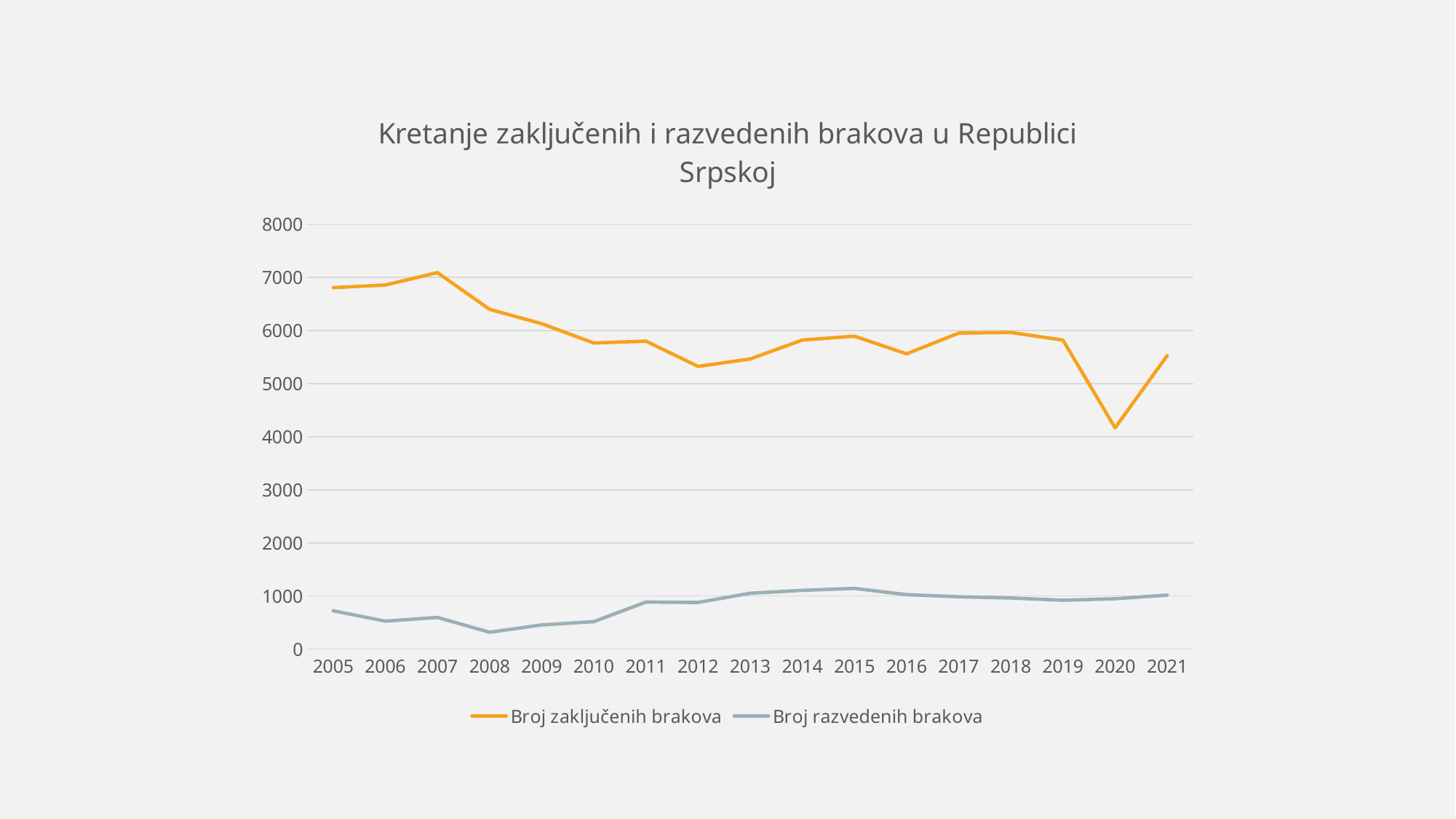
Is the value for Broj razvedenih brakova in 2008 greater or less than 500? less In which year is the value for Broj razvedenih brakova lowest? 2008 Is the value for Broj zaključenih brakova in 2020 greater or less than 5000? less Which year has the larger value for Broj zaključenih brakova, 2005 or 2021? 2005 Is the value for Broj zaključenih brakova in 2007 greater or less than 7000? greater What is the title of the chart? Kretanje zaključenih i razvedenih brakova u Republici Srpskoj How many series does the legend list? 2 How many years are plotted along the x axis? 17 Does the Broj zaključenih brakova line overall rise or fall from 2005 to 2021? fall In which year is the value for Broj zaključenih brakova highest? 2007 What kind of chart is shown on the slide? line chart In which year is the value for Broj zaključenih brakova lowest? 2020